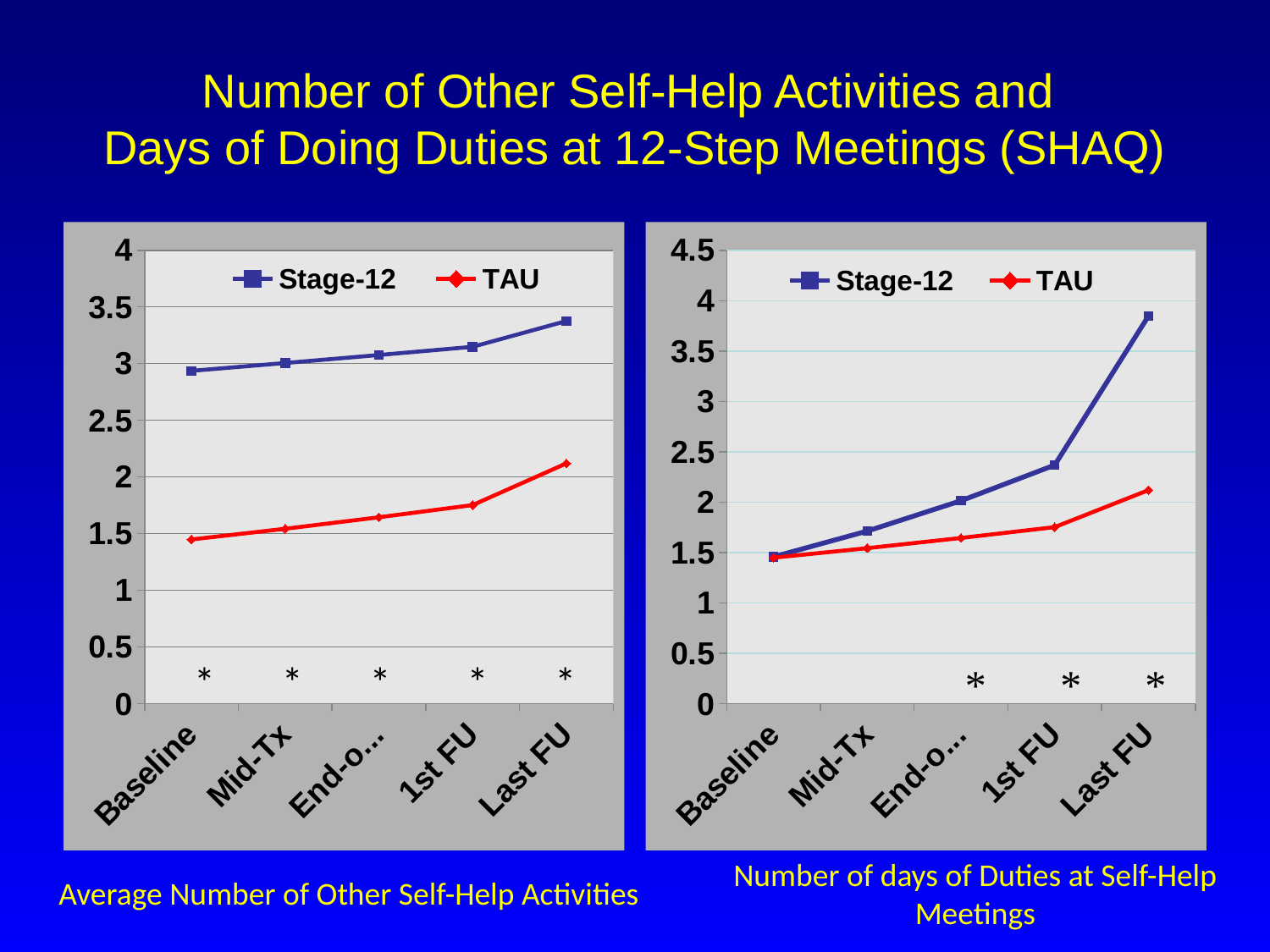
How many series does the legend of the right chart, Number of days of Duties at Self-Help Meetings, list? 2 In the left chart, Average Number of Other Self-Help Activities, is the TAU value at Baseline greater or less than 2? less What colour is the TAU line in the left chart, Average Number of Other Self-Help Activities? red In the left chart, Average Number of Other Self-Help Activities, which series is higher at Baseline, Stage-12 or TAU? Stage-12 In the right chart, Number of days of Duties at Self-Help Meetings, which series is higher at 1st FU, Stage-12 or TAU? Stage-12 In the left chart, Average Number of Other Self-Help Activities, is the Stage-12 value at Last FU greater or less than 3? greater What kind of chart is the left chart, Average Number of Other Self-Help Activities? line chart In the right chart, Number of days of Duties at Self-Help Meetings, at which time point is the Stage-12 series highest? Last FU In the right chart, Number of days of Duties at Self-Help Meetings, does the Stage-12 line rise or fall from Baseline to Last FU? rise How many time points are shown on the x axis of the left chart, Average Number of Other Self-Help Activities? 5 In the left chart, Average Number of Other Self-Help Activities, at which time point is the TAU series lowest? Baseline In the right chart, Number of days of Duties at Self-Help Meetings, is the Stage-12 value at Last FU greater or less than 3.5? greater